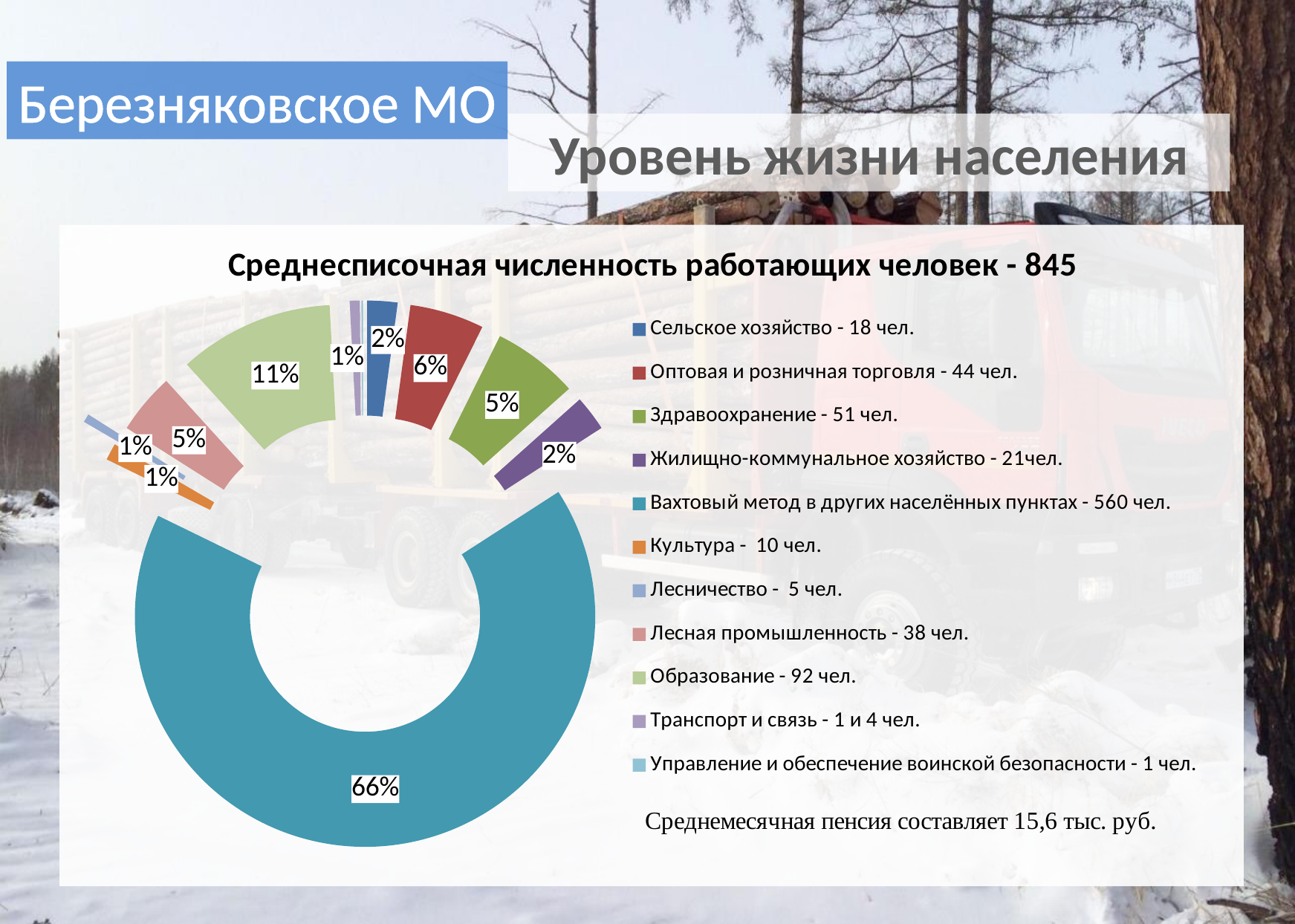
How many people are listed for 'Здравоохранение' in the legend? 51 чел. What kind of chart is shown on the slide? Doughnut (pie) chart Which category has the largest slice in the chart? Вахтовый метод в других населённых пунктах What is the difference between the number of people in 'Образование' and in 'Лесная промышленность'? 54 чел. What share of the chart does 'Вахтовый метод в других населённых пунктах' take? 66% Which category has the smallest number of people according to the legend? Управление и обеспечение воинской безопасности Which is larger, the slice for 'Образование' or the slice for 'Лесная промышленность'? Образование What is the title of the chart? Среднесписочная численность работающих человек - 845 How many people are listed for 'Образование' in the legend? 92 чел. What share of the chart does 'Образование' take? 11% How many categories does the legend list? 11 What share of the chart does 'Оптовая и розничная торговля' take? 6%